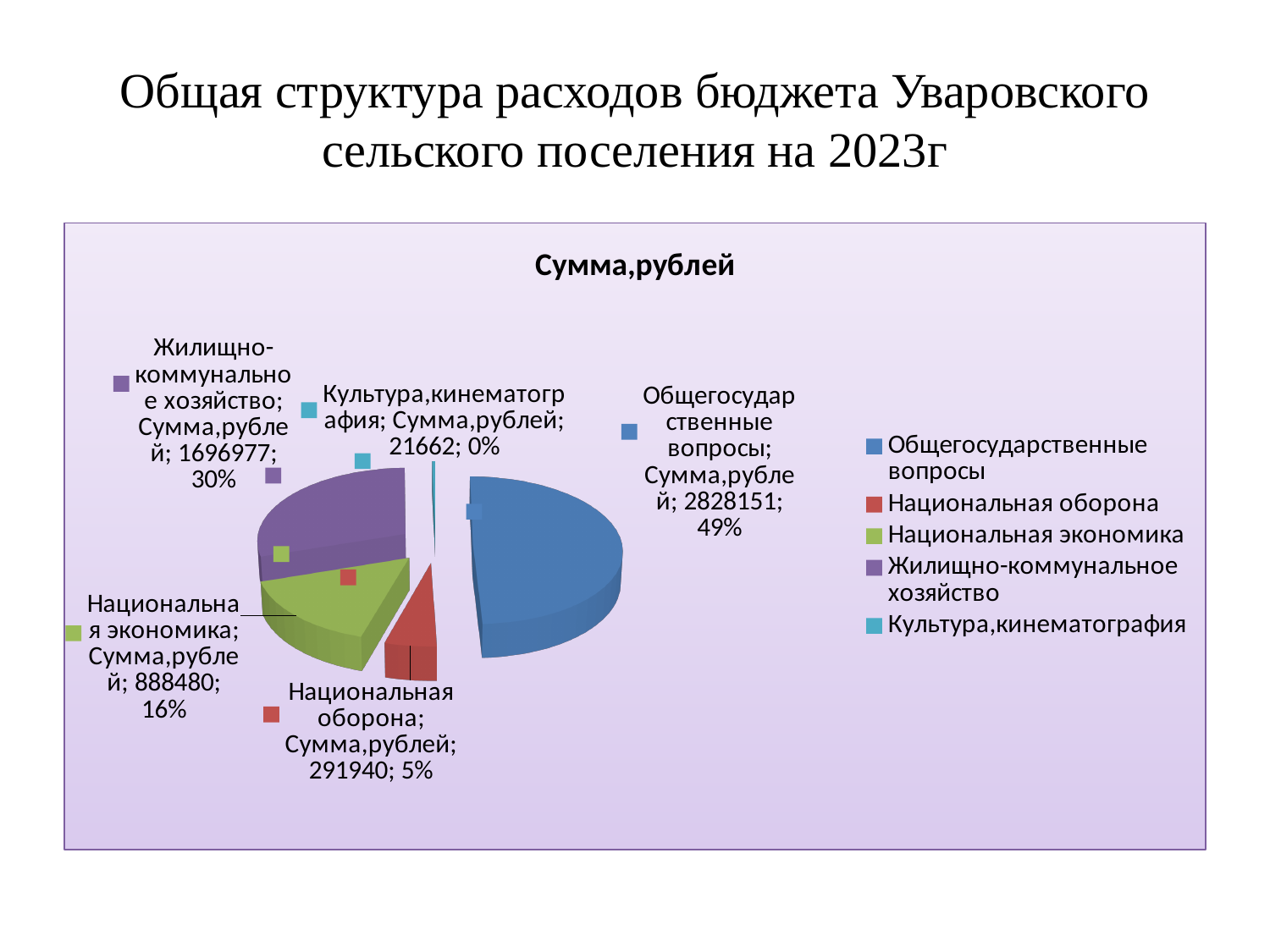
What is the value for Национальная оборона? 291940 Which is larger, the value for Национальная экономика or the value for Национальная оборона? Национальная экономика Which category has the largest slice? Общегосударственные вопросы Which category has the smallest slice? Культура,кинематография What is the value for Общегосударственные вопросы? 2828151 What type of chart is shown on the slide? pie chart What is the value for Жилищно-коммунальное хозяйство? 1696977 What share of the pie does Общегосударственные вопросы represent? 49% How many categories does the legend list? 5 What share of the pie does Национальная экономика represent? 16% What is the value for Культура,кинематография? 21662 What is the difference between the values for Общегосударственные вопросы and Жилищно-коммунальное хозяйство? 1131174